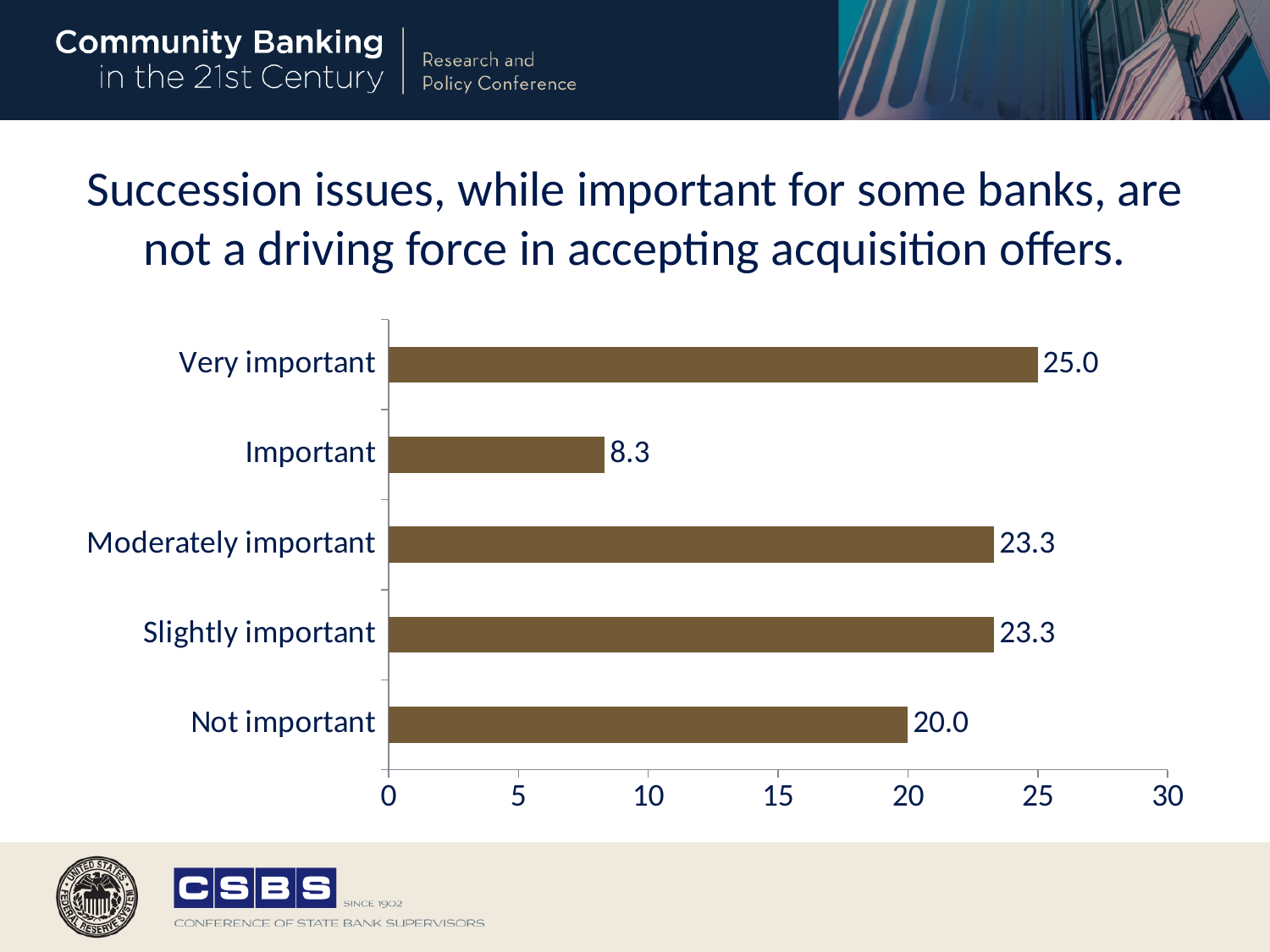
What kind of chart is shown on the slide? bar chart Which category has the lowest value? Important Which category has the highest value? Very important Is the value for Important greater or less than 10? less What is the value for Moderately important? 23.3 What is the difference between the values for Very important and Important? 16.7 What is the value for Not important? 20.0 Which is larger, the value for Not important or the value for Slightly important? Slightly important What is the value for Very important? 25.0 What is the difference between the values for Moderately important and Not important? 3.3 How many categories are shown in the chart? 5 What is the value for Important? 8.3